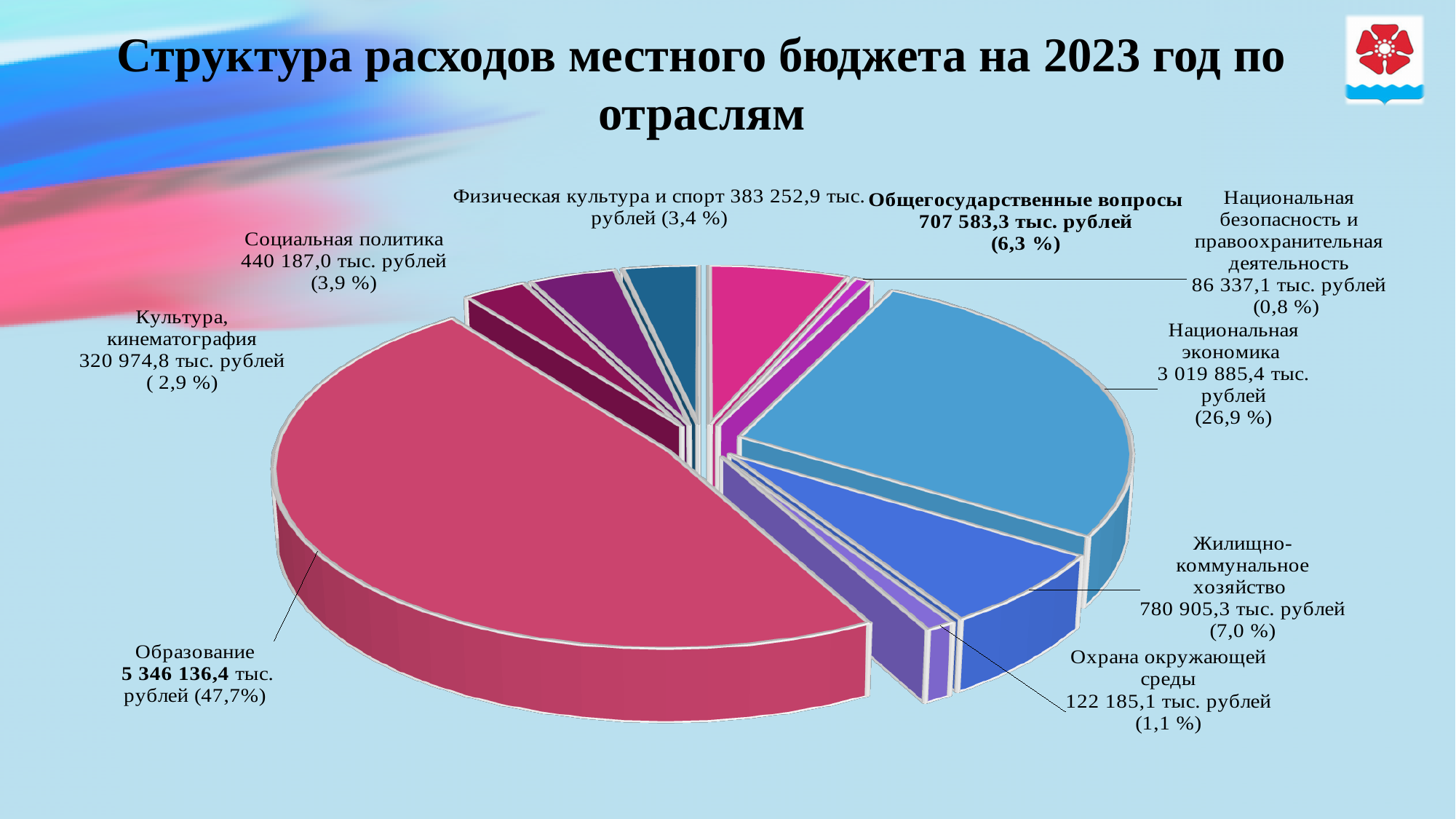
Which category has the largest share of the pie? Образование How many categories (slices) does the pie chart show? 9 What share of the pie does Охрана окружающей среды represent? 1,1 % Which category has the smallest share of the pie? Национальная безопасность и правоохранительная деятельность What is the value for Образование? 5 346 136,4 тыс. рублей What is the value for Жилищно-коммунальное хозяйство? 780 905,3 тыс. рублей What is the difference in value between Социальная политика and Физическая культура и спорт? 56 934,1 тыс. рублей What kind of chart is shown on the slide? Pie chart Which is larger: Социальная политика or Физическая культура и спорт? Социальная политика What is the title of the chart on the slide? Структура расходов местного бюджета на 2023 год по отраслям What is the value for Культура, кинематография? 320 974,8 тыс. рублей What share of the pie does Национальная экономика represent? 26,9 %